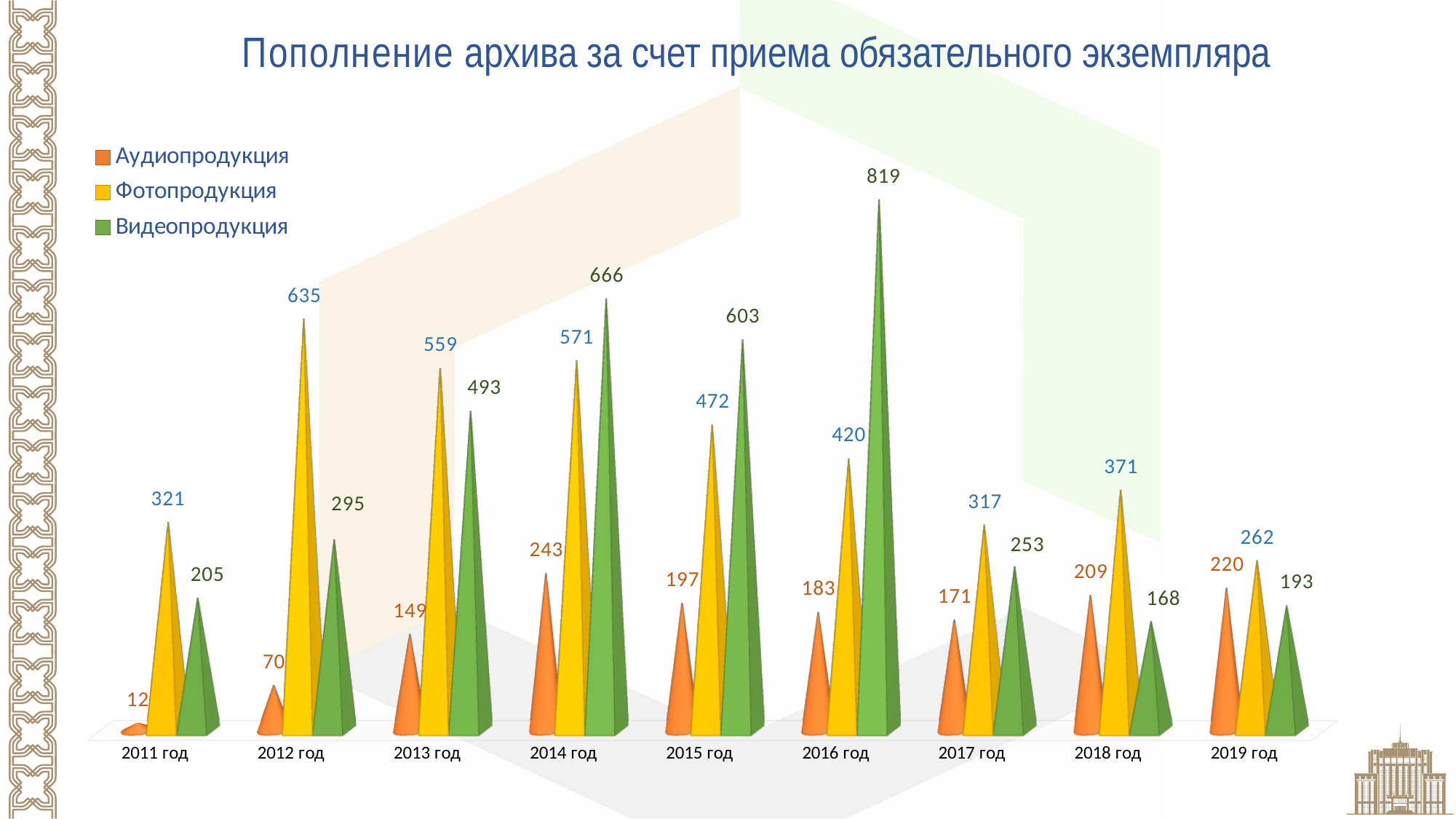
What is the value for Аудиопродукция in 2011 год? 12 What kind of chart is shown on the slide? bar chart What is the difference between Видеопродукция and Фотопродукция in 2014 год? 95 How many years are shown on the x axis? 9 What is the value for Видеопродукция in 2016 год? 819 Which is larger in 2018 год: Фотопродукция or Видеопродукция? Фотопродукция What is the value for Фотопродукция in 2012 год? 635 In which year is Аудиопродукция lowest? 2011 год In which year is Видеопродукция highest? 2016 год How many series does the legend list? 3 What is the total of the three series in 2019 год? 675 What colour represents Видеопродукция in the legend? green